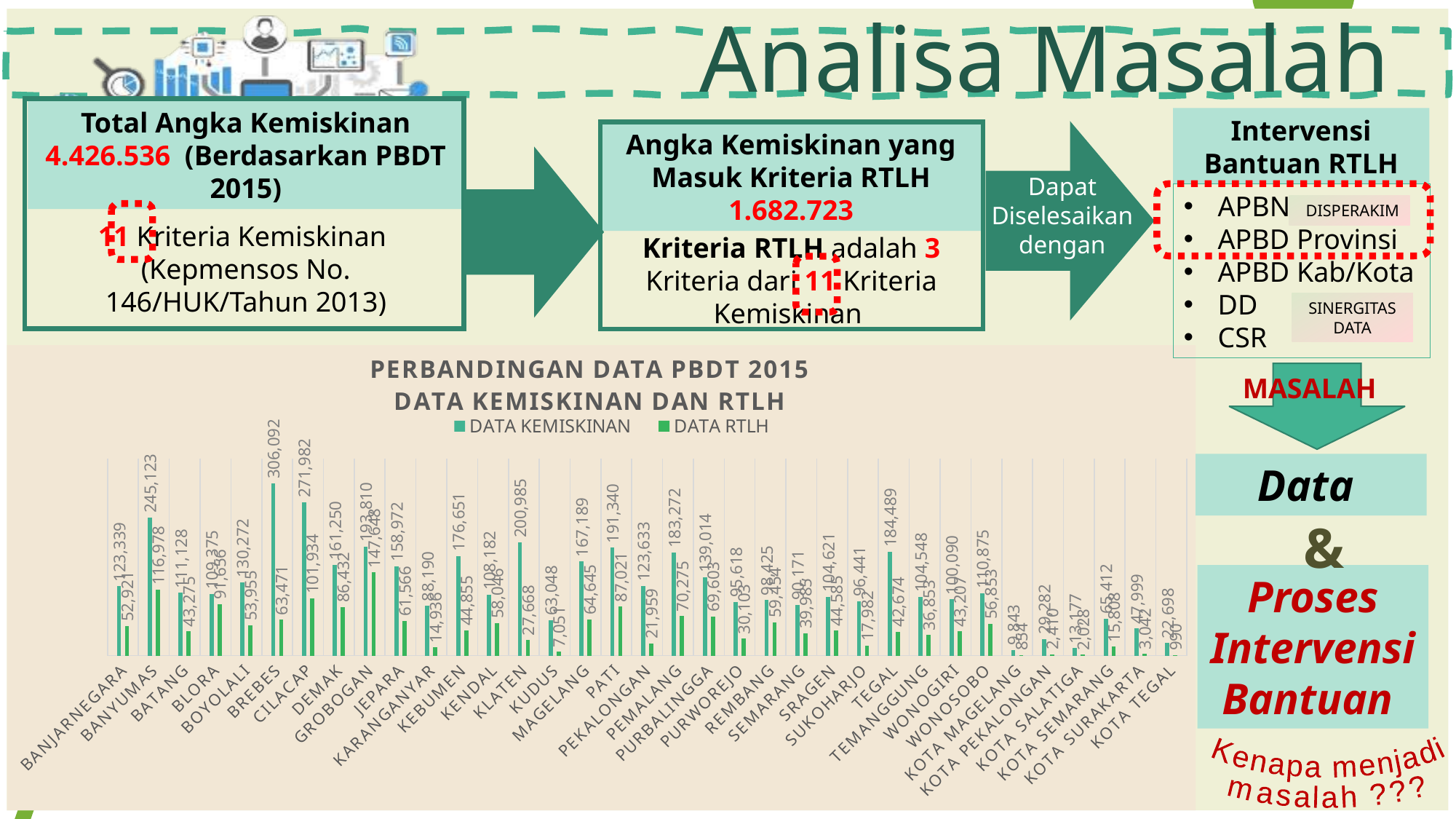
What is the DATA KEMISKINAN value for CILACAP? 271,982 How many series does the chart legend list? 2 What is the DATA KEMISKINAN value for BREBES? 306,092 Which region has the highest DATA KEMISKINAN value? BREBES Which region has the highest DATA RTLH value? GROBOGAN What is the difference between DATA KEMISKINAN and DATA RTLH for BREBES? 242,621 How many categories (regions) are shown on the x axis of the chart? 35 Which has a larger DATA KEMISKINAN value, BREBES or CILACAP? BREBES What is the DATA RTLH value for KLATEN? 27,668 What is the DATA RTLH value for BANYUMAS? 116,978 What type of chart is shown on the slide? Bar chart What is the title of the chart? PERBANDINGAN DATA PBDT 2015 DATA KEMISKINAN DAN RTLH